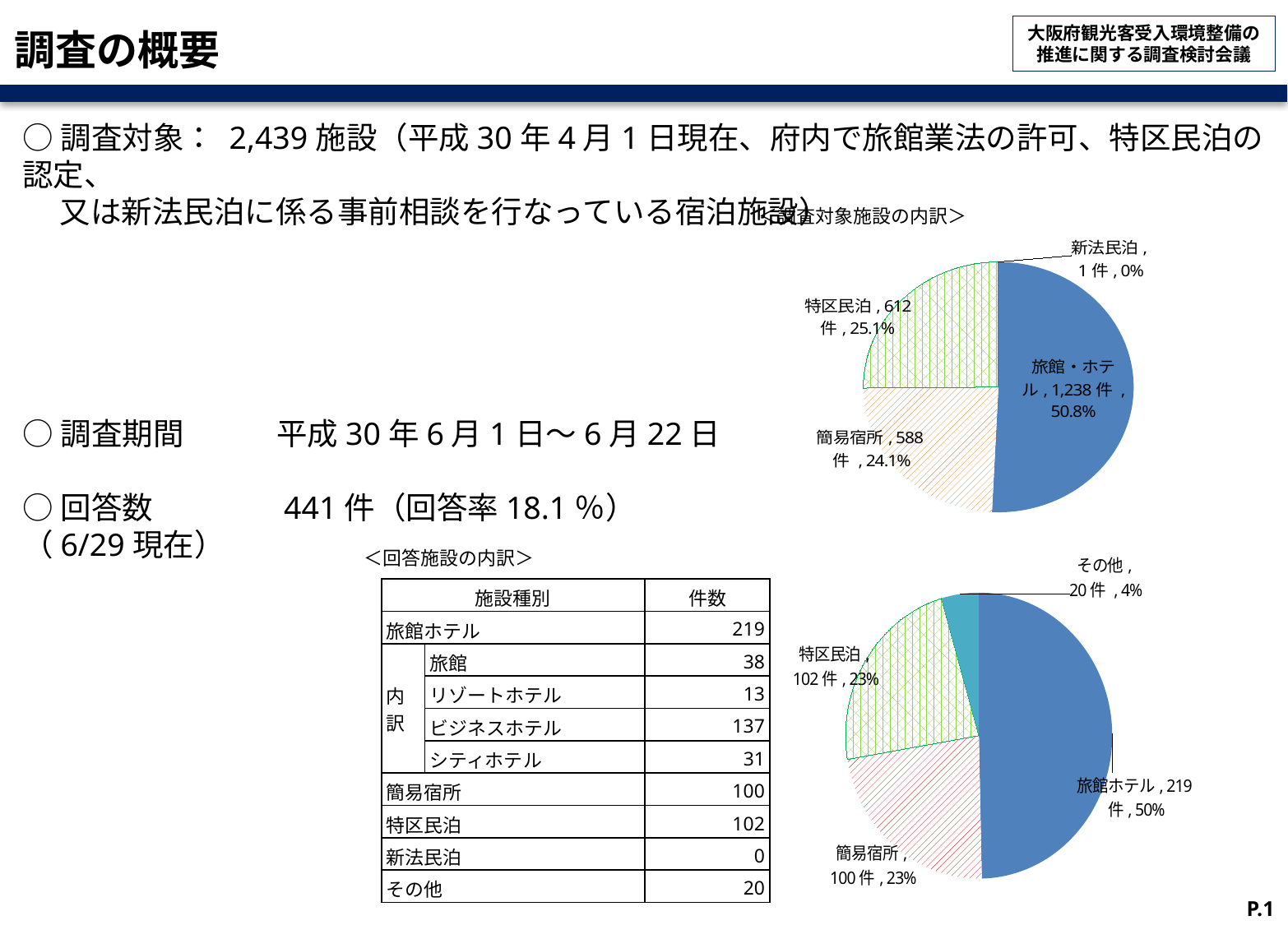
What type of chart is used for 回答施設の内訳 at the bottom of the slide? Pie chart In the bottom pie chart (回答施設の内訳), what share of the pie does その他 represent? 4% In the top pie chart (調査対象施設の内訳), what is the difference in count between 特区民泊 and 簡易宿所? 24 件 In the bottom pie chart (回答施設の内訳), how many facilities are in the 旅館ホテル category? 219 件 In the bottom pie chart (回答施設の内訳), what is the difference in count between 旅館ホテル and その他? 199 件 In the top pie chart (調査対象施設の内訳), which category has the largest slice? 旅館・ホテル In the bottom pie chart (回答施設の内訳), which is larger in count, 特区民泊 or 簡易宿所? 特区民泊 How many slices does the top pie chart (調査対象施設の内訳) have? 4 What is the title of the top chart on the slide? 調査対象施設の内訳 In the top pie chart (調査対象施設の内訳), what share of the pie does 特区民泊 represent? 25.1% In the top pie chart (調査対象施設の内訳), which category has the smallest slice? 新法民泊 In the top pie chart (調査対象施設の内訳), how many facilities are in the 旅館・ホテル category? 1,238 件